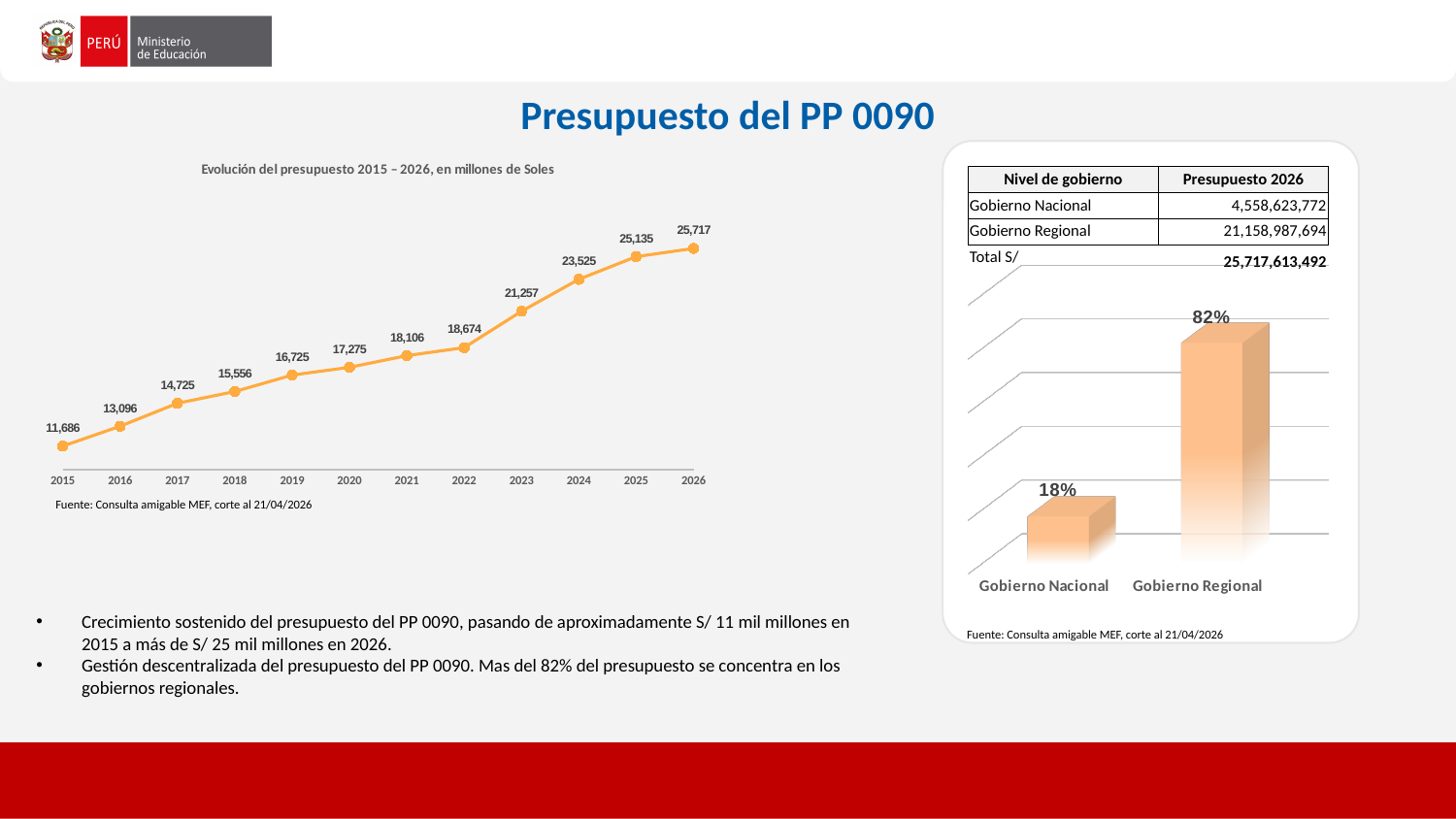
In the bar chart on the right, what is the value for Gobierno Regional? 82% In the bar chart on the right, which is larger, Gobierno Nacional or Gobierno Regional? Gobierno Regional In the line chart 'Evolución del presupuesto 2015 – 2026', do the values rise or fall from 2015 to 2026? rise What kind of chart is the 'Evolución del presupuesto 2015 – 2026' chart on the left? line chart In the line chart 'Evolución del presupuesto 2015 – 2026', how many years are plotted? 12 In the line chart 'Evolución del presupuesto 2015 – 2026', which year has the highest value? 2026 In the line chart 'Evolución del presupuesto 2015 – 2026', what is the value for 2021? 18,106 In the line chart 'Evolución del presupuesto 2015 – 2026', what is the difference between the 2026 value and the 2015 value? 14,031 In the line chart 'Evolución del presupuesto 2015 – 2026', which year has the lowest value? 2015 In the line chart 'Evolución del presupuesto 2015 – 2026', what is the value for 2015? 11,686 What kind of chart is the chart on the right showing Gobierno Nacional and Gobierno Regional? bar chart In the line chart 'Evolución del presupuesto 2015 – 2026', what is the value for 2026? 25,717